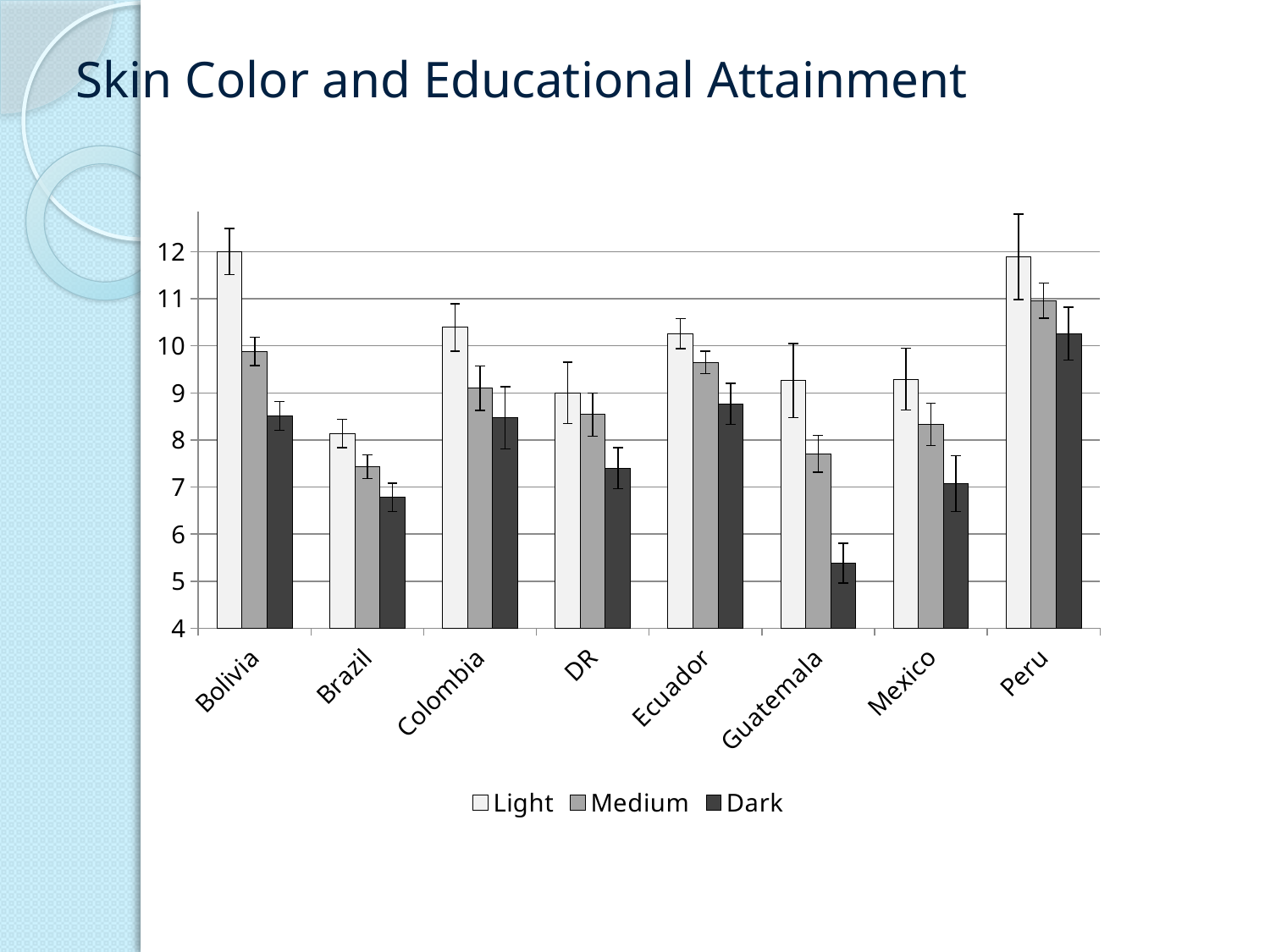
Is the value for the Dark series in Brazil greater or less than 7? less Is the value for the Dark series in Guatemala greater or less than 6? less What is the title of the slide containing the chart? Skin Color and Educational Attainment What are the three series named in the legend? Light, Medium, Dark Which is larger, the Medium value for Bolivia or the Medium value for Brazil? Bolivia What kind of chart is shown on the slide? bar chart How many countries are shown on the x axis of the chart? 8 Which country has the highest value for the Dark series? Peru Which country has the lowest value for the Dark series? Guatemala How many series does the chart's legend list? 3 Is the value for the Light series in Peru greater or less than 11? greater Which country has the lowest value for the Light series? Brazil